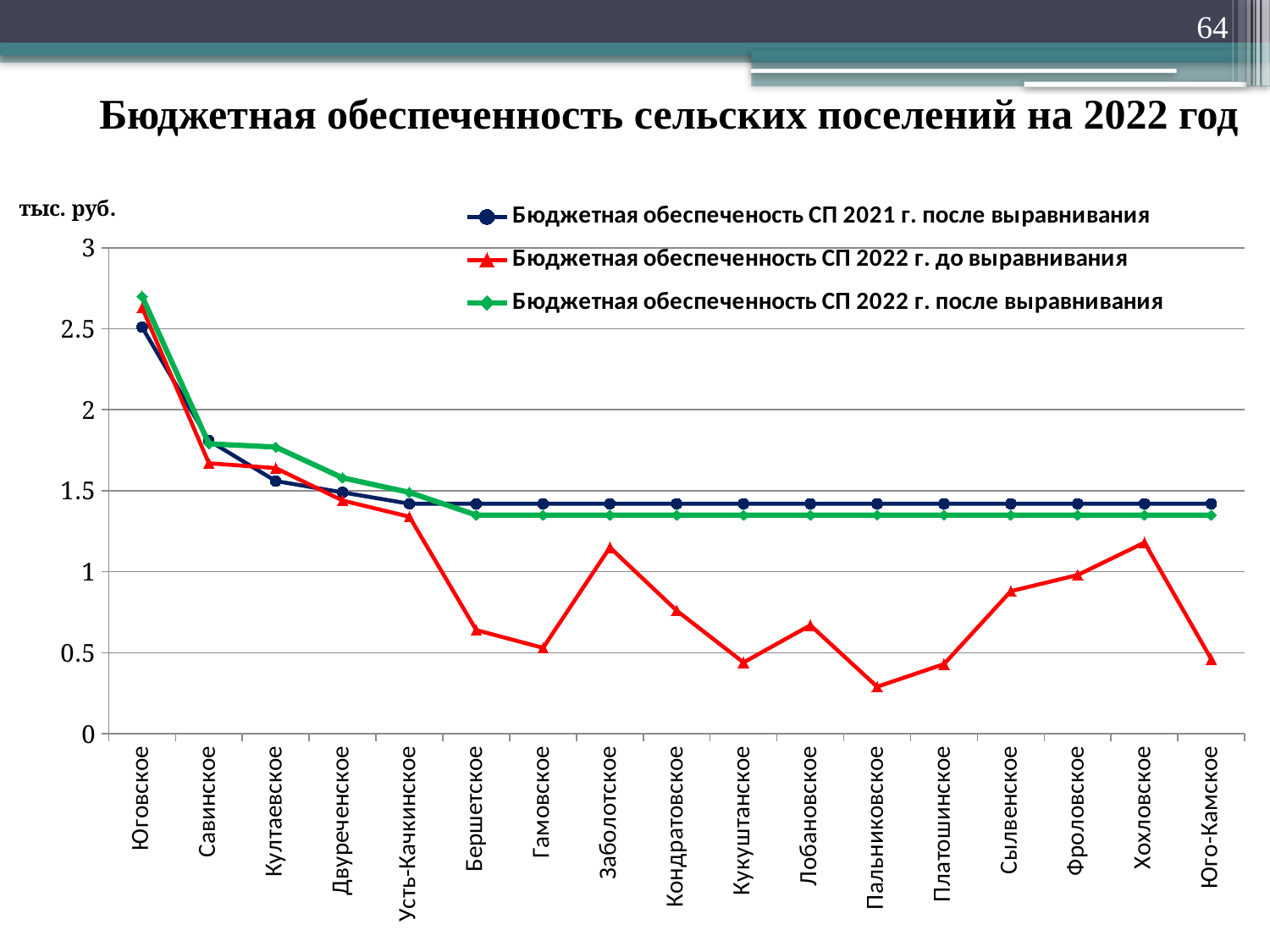
How many series does the legend list? 3 Does the series 'Бюджетная обеспеченность СП 2022 г. до выравнивания' rise or fall from Юговское to Усть-Качкинское? Fall For Култаевское, which series has the larger value: 'Бюджетная обеспеченность СП 2022 г. после выравнивания' or 'Бюджетная обеспеченость СП 2021 г. после выравнивания'? Бюджетная обеспеченность СП 2022 г. после выравнивания How many settlements (categories) are plotted along the x axis? 17 What unit is shown above the y axis of the chart? тыс. руб. Which settlement has the lowest value for the series 'Бюджетная обеспеченность СП 2022 г. до выравнивания'? Пальниковское For Пальниковское, which series has the larger value: 'Бюджетная обеспеченность СП 2022 г. после выравнивания' or 'Бюджетная обеспеченность СП 2022 г. до выравнивания'? Бюджетная обеспеченность СП 2022 г. после выравнивания Is the value for Юговское in the series 'Бюджетная обеспеченность СП 2022 г. после выравнивания' greater or less than 2.5? greater Which settlement has the highest value for the series 'Бюджетная обеспеченность СП 2022 г. до выравнивания'? Юговское Is the value for Заболотское in the series 'Бюджетная обеспеченность СП 2022 г. до выравнивания' greater or less than 1? greater What kind of chart is shown on the slide? Line chart Is the value for Кукуштанское in the series 'Бюджетная обеспеченность СП 2022 г. до выравнивания' greater or less than 0.5? less